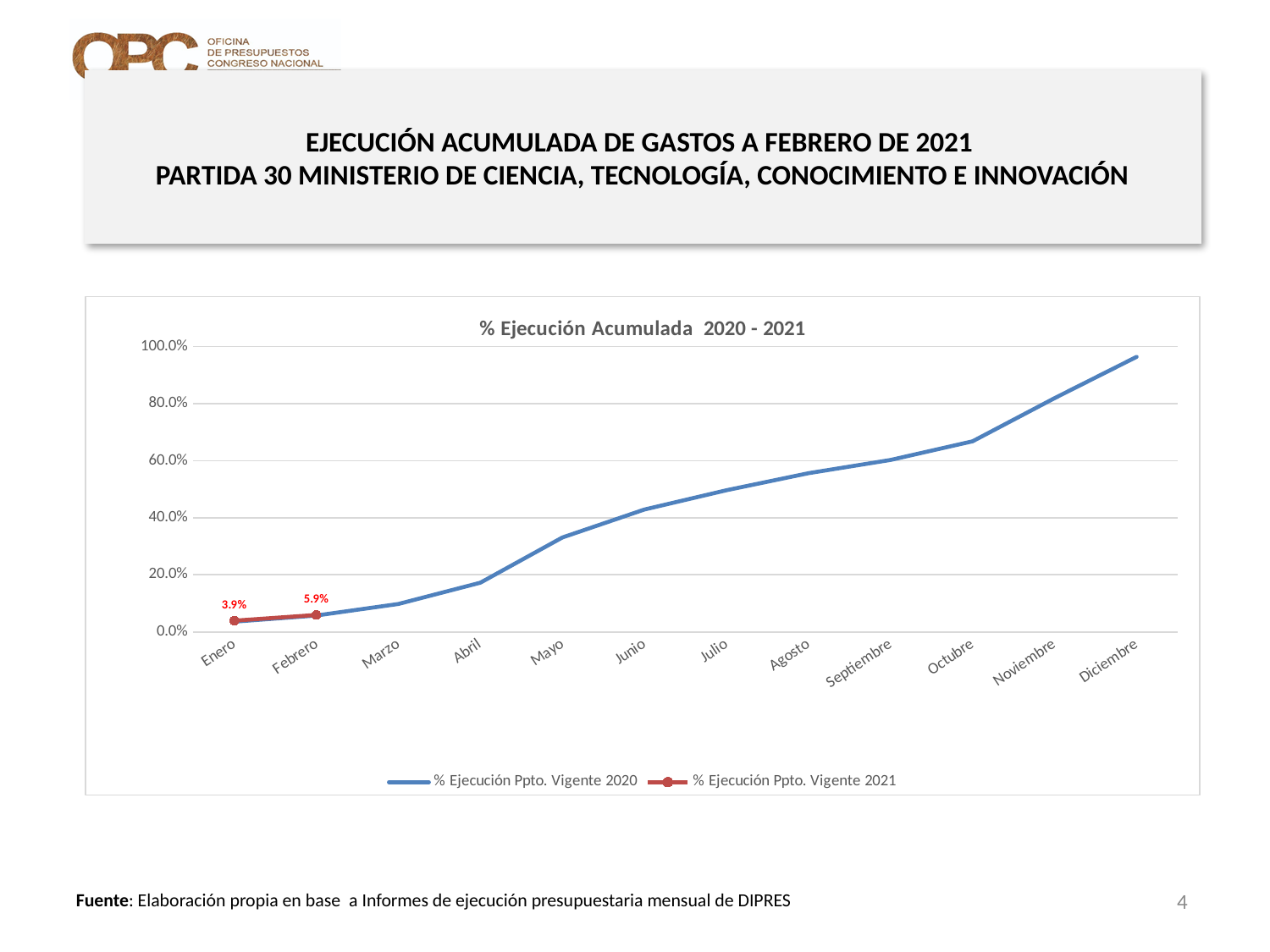
What kind of chart is shown on the slide? Line chart Is the value of % Ejecución Ppto. Vigente 2020 for Abril greater or less than 20.0%? less Which month has the higher value in the % Ejecución Ppto. Vigente 2021 series, Enero or Febrero? Febrero What is the title of the chart? % Ejecución Acumulada 2020 - 2021 How many series does the chart legend list? 2 Is the value of % Ejecución Ppto. Vigente 2020 for Diciembre greater or less than 80.0%? greater Does the % Ejecución Ppto. Vigente 2020 series rise or fall from Enero to Diciembre? Rise How many months are shown on the x axis of the chart? 12 What is the difference between the Febrero and Enero values of the % Ejecución Ppto. Vigente 2021 series? 2.0% What is the value of % Ejecución Ppto. Vigente 2021 for Febrero? 5.9% Is the value of % Ejecución Ppto. Vigente 2020 for Octubre greater or less than 60.0%? greater What is the value of % Ejecución Ppto. Vigente 2021 for Enero? 3.9%